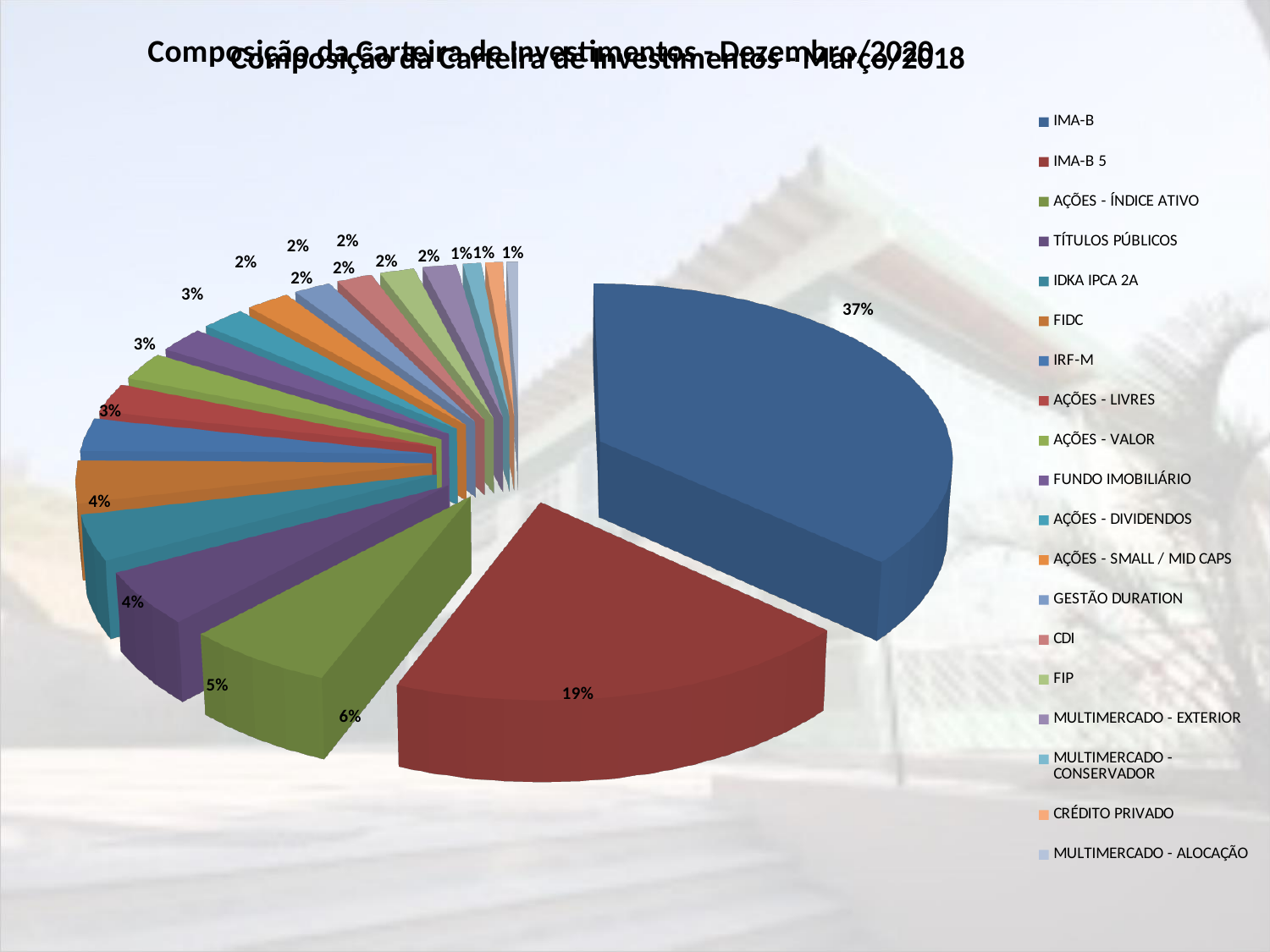
What is the share of the AÇÕES - ÍNDICE ATIVO slice? 6% What is the difference in percentage points between the IMA-B slice and the IMA-B 5 slice? 18 percentage points What colour is the IMA-B slice in the pie chart? Blue What is the combined share of the IMA-B and IMA-B 5 slices? 56% How many categories does the legend list? 19 What is the share of the TÍTULOS PÚBLICOS slice? 5% Which category has the largest share of the pie? IMA-B What is the share of the IMA-B 5 slice? 19% What type of chart is shown on the slide? Pie chart What is the share of the IMA-B slice? 37% Which is larger, the AÇÕES - ÍNDICE ATIVO slice or the TÍTULOS PÚBLICOS slice? AÇÕES - ÍNDICE ATIVO Which is larger, the IMA-B slice or the IMA-B 5 slice? IMA-B